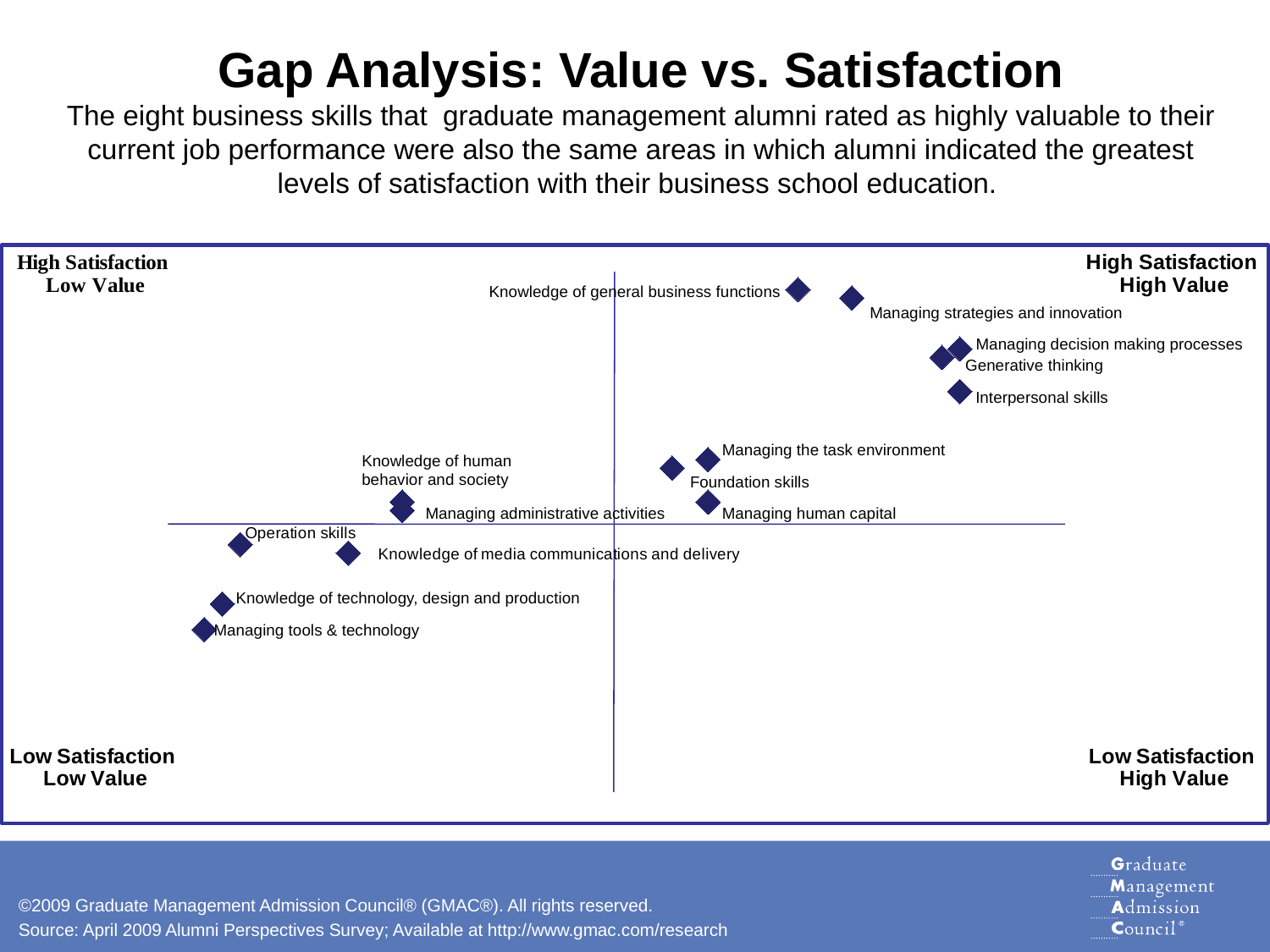
How many skills fall in the High Satisfaction / High Value quadrant? 8 How many business skills are plotted on the chart? 14 What is the title of the slide's chart? Gap Analysis: Value vs. Satisfaction How many skills fall in the Low Satisfaction / High Value quadrant? 0 Which skill is plotted with the highest satisfaction? Knowledge of general business functions Which skill is plotted with the lowest satisfaction? Managing tools & technology In which quadrant is Managing tools & technology plotted? Low Satisfaction, Low Value Is Operation skills plotted with higher or lower satisfaction than Foundation skills? Lower In which quadrant is Interpersonal skills plotted? High Satisfaction, High Value In which quadrant is Managing administrative activities plotted? High Satisfaction, Low Value What kind of chart is shown on the slide? Scatter chart